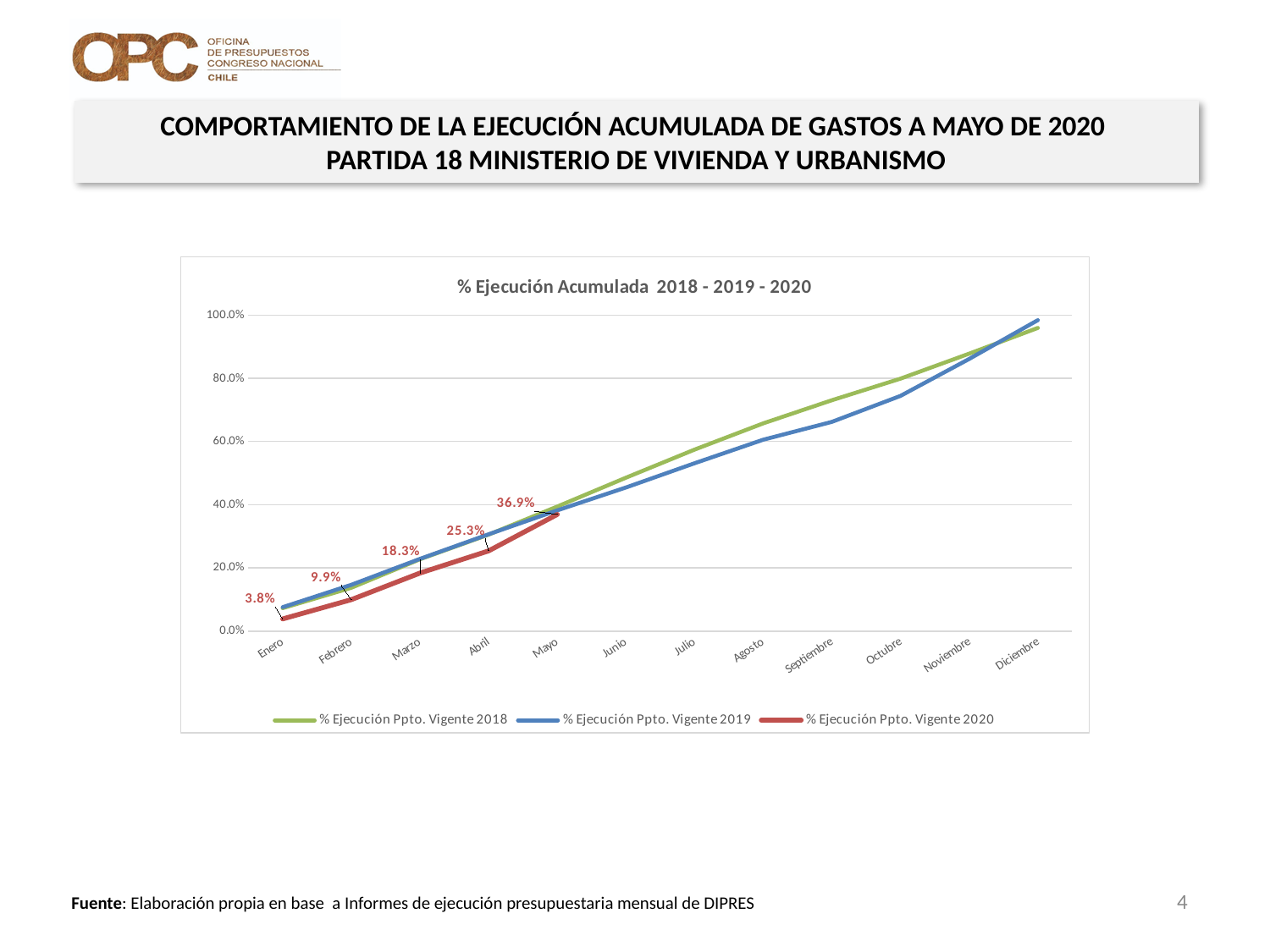
Which month has the lowest value in the % Ejecución Ppto. Vigente 2020 series? Enero What is the value for Mayo in the % Ejecución Ppto. Vigente 2020 series? 36.9% What is the value for Enero in the % Ejecución Ppto. Vigente 2020 series? 3.8% Which month has the highest value in the % Ejecución Ppto. Vigente 2020 series? Mayo What is the title of the chart? % Ejecución Acumulada 2018 - 2019 - 2020 What is the difference between the Mayo and Abril values in the % Ejecución Ppto. Vigente 2020 series? 11.6% How many series does the legend list? 3 What kind of chart is shown? Line chart What is the value for Abril in the % Ejecución Ppto. Vigente 2020 series? 25.3% What is the value for Marzo in the % Ejecución Ppto. Vigente 2020 series? 18.3% How many months are shown on the x axis? 12 Is the value for Julio in the % Ejecución Ppto. Vigente 2018 series greater or less than 40%? greater